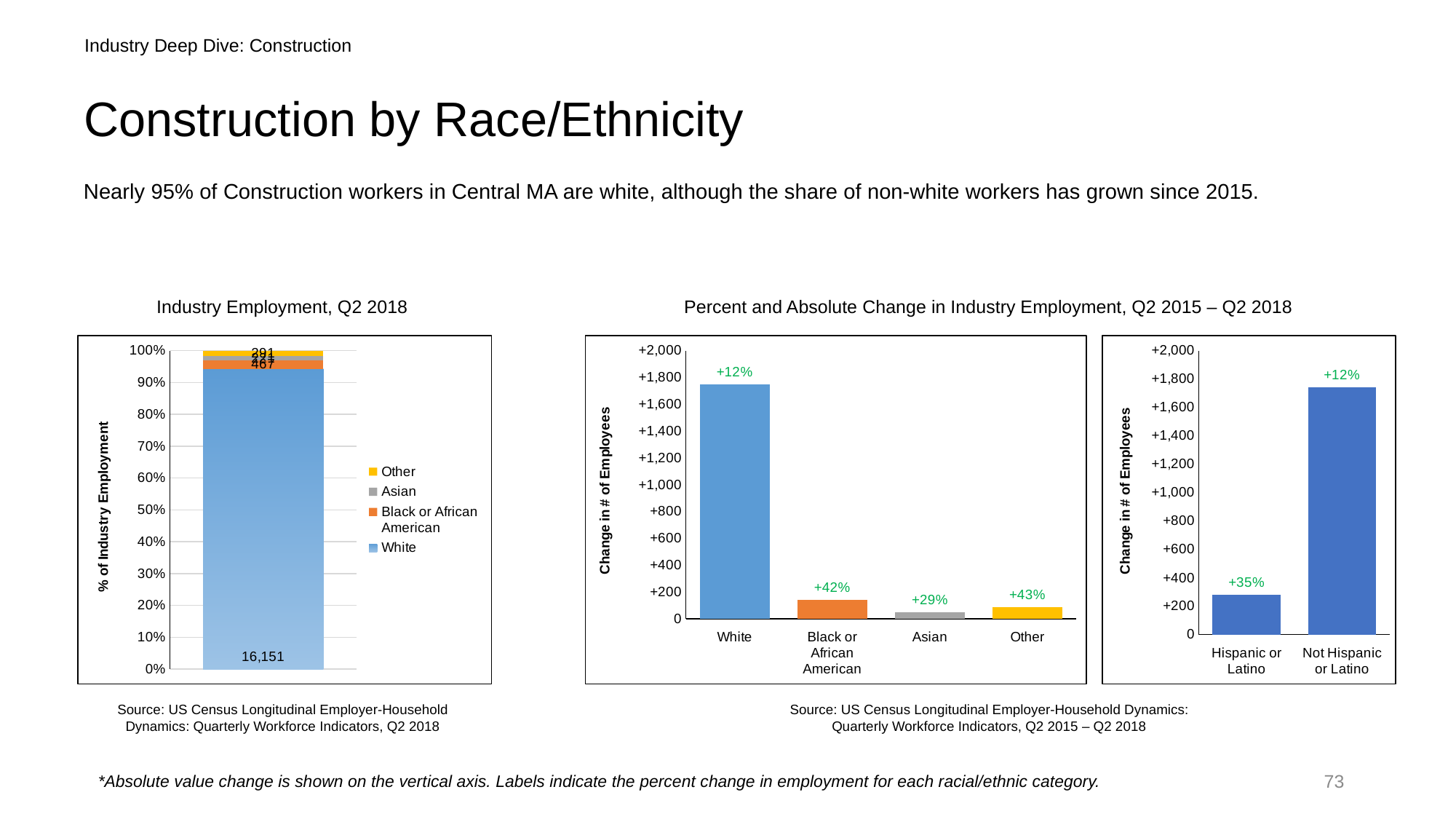
In the right chart (Percent and Absolute Change in Industry Employment by Hispanic or Latino status), is the absolute change for Hispanic or Latino greater or less than 400? less In the middle chart (Percent and Absolute Change in Industry Employment by race), what percent change label is shown for Black or African American? +42% In the right chart (Percent and Absolute Change in Industry Employment by Hispanic or Latino status), which category has the larger absolute change, Hispanic or Latino or Not Hispanic or Latino? Not Hispanic or Latino In the Industry Employment, Q2 2018 chart, what value is printed on the White segment of the bar? 16,151 In the middle chart (Percent and Absolute Change in Industry Employment by race), is the absolute change for White greater or less than 1,600? greater In the right chart (Percent and Absolute Change in Industry Employment by Hispanic or Latino status), what percent change label is shown for Hispanic or Latino? +35% How many series does the legend of the Industry Employment, Q2 2018 chart list? 4 In the middle chart (Percent and Absolute Change in Industry Employment by race), which category has the tallest bar (largest absolute change)? White In the middle chart (Percent and Absolute Change in Industry Employment by race), what percent change label is shown for Asian? +29% In the middle chart (Percent and Absolute Change in Industry Employment by race), which category has the shortest bar (smallest absolute change)? Asian In the middle chart (Percent and Absolute Change in Industry Employment by race), how many categories are shown on the x axis? 4 What kind of chart is the Industry Employment, Q2 2018 chart? Stacked bar chart